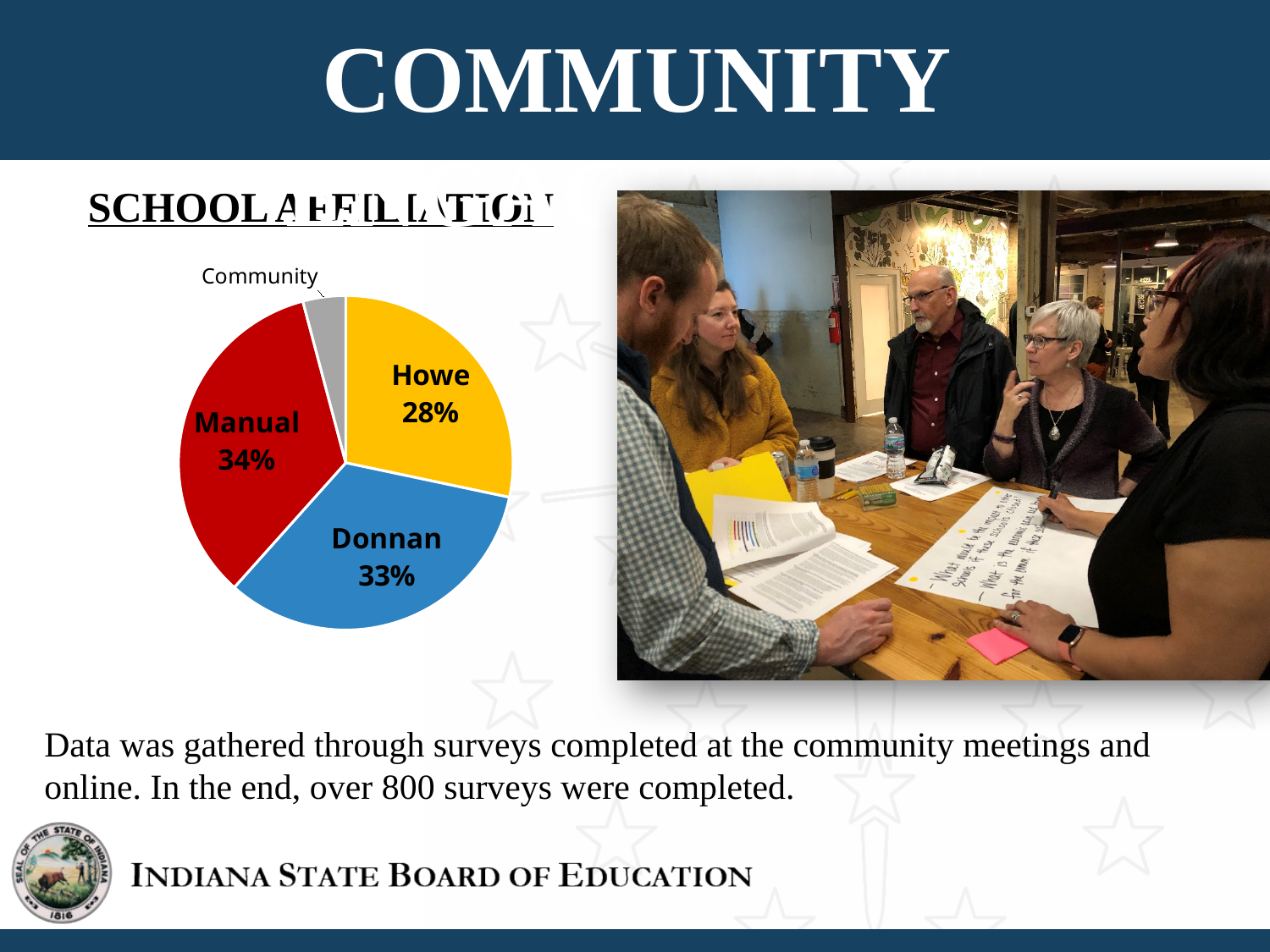
What percentage of the pie chart is Howe? 28% Which school has the largest share in the pie chart? Manual What kind of chart is shown on the slide? pie chart Which is larger in the pie chart, Howe or Donnan? Donnan What percentage of the pie chart is Manual? 34% Which slice of the pie chart is the smallest? Community What percentage of the pie chart is Donnan? 33% How many slices does the pie chart have? 4 What is the difference in percentage points between Manual and Howe? 6% What colour is the Manual slice of the pie chart? red What is the difference in percentage points between Donnan and Howe? 5% What is the title of the pie chart? SCHOOL AFFILIATION